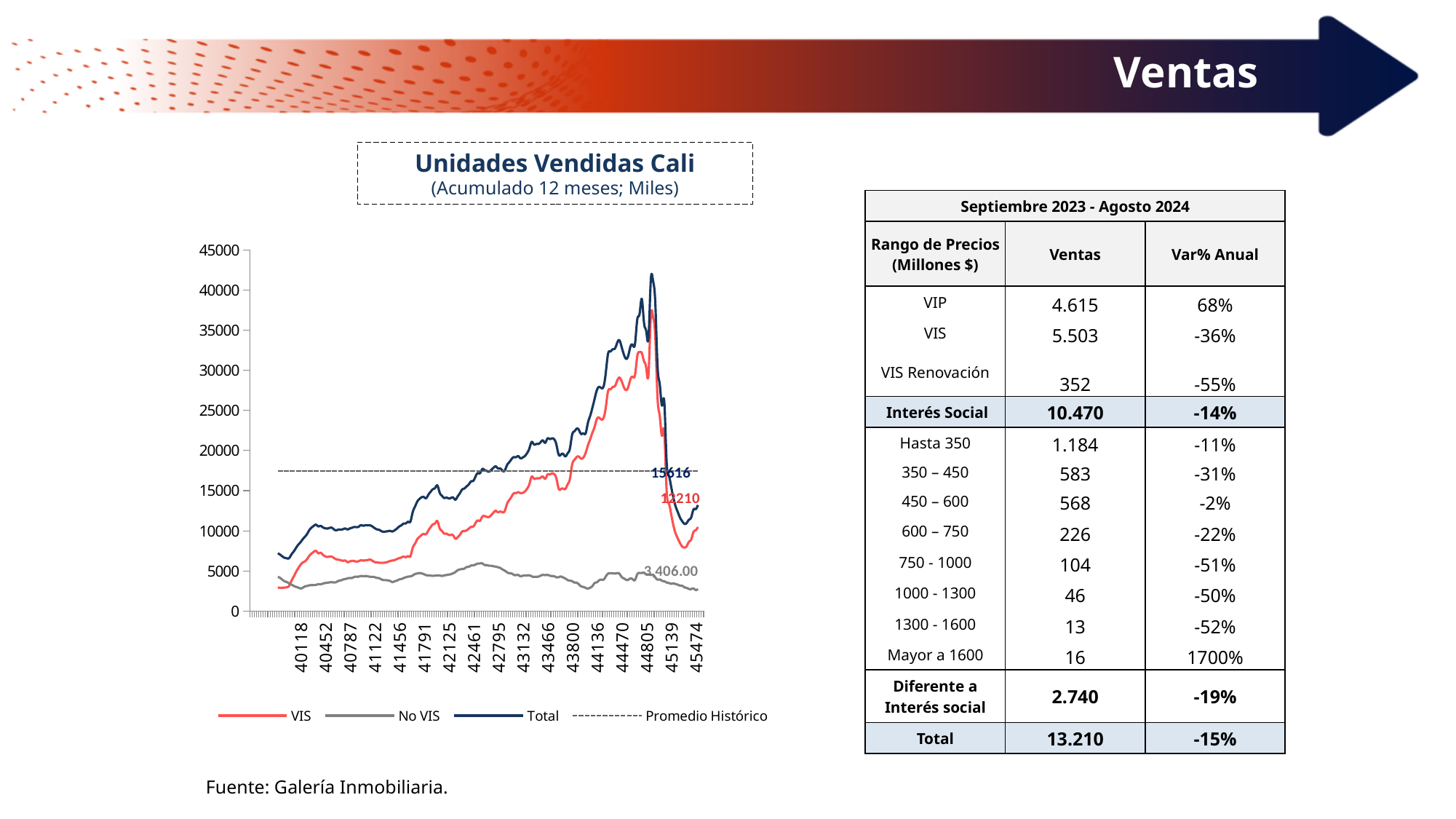
Which series reaches the highest value in the chart? Total Which series is represented by the dashed line in the chart? Promedio Histórico How many series does the chart legend list? 4 What is the title of the chart? Unidades Vendidas Cali Is the peak value of the Total series greater or less than 40000? greater Which series stays lowest across the chart? No VIS What is the data label shown for the VIS series in the chart? 12210 What type of chart is shown on the slide? line chart At the right end of the chart, which is larger: the Total series or the No VIS series? Total Is the peak value of the No VIS series greater or less than 10000? less What is the data label shown for the Total series in the chart? 15616 What is the data label shown for the No VIS series in the chart? 3,406.00